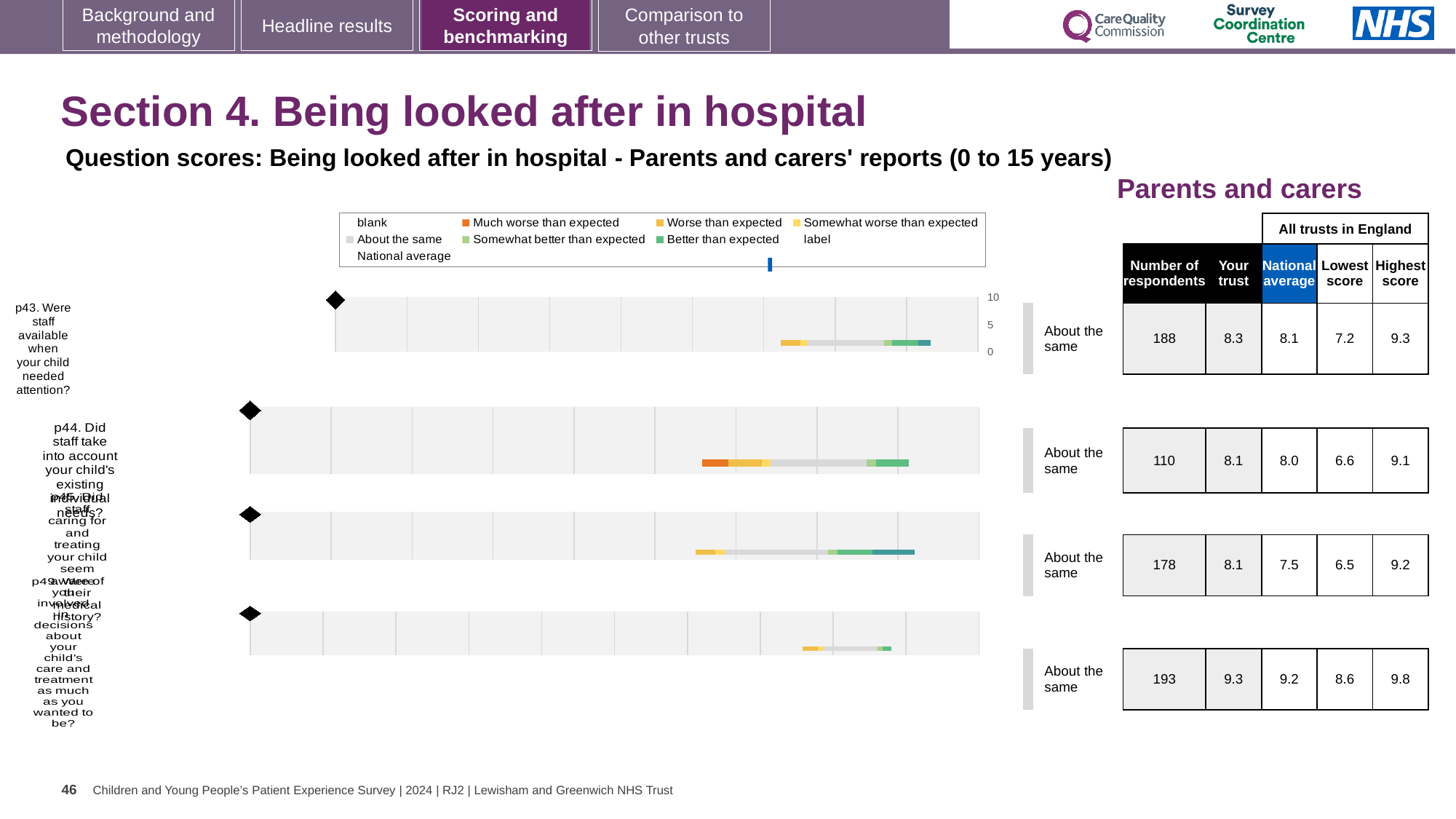
For p44 (Did staff take into account your child's existing individual needs?), what is the national average score? 8.0 Which question has the fewest respondents? p44 For p43 (Were staff available when your child needed attention?), what is the 'Your trust' score? 8.3 For p45, what is the lowest score among all trusts in England? 6.5 What is the difference between the 'Your trust' score and the national average for p45? 0.6 For p43, what is the number of respondents? 188 How many question rows (charts) are shown on the slide? 4 For p44, which is larger: the 'Your trust' score or the national average? Your trust What benchmark category is shown for all four questions? About the same Which question has the highest 'Your trust' score? p49 What kind of chart is used to show the question scores on this slide? bar chart For p49 (Were you involved in decisions about your child's care and treatment as much as you wanted to be?), what is the highest score among all trusts in England? 9.8